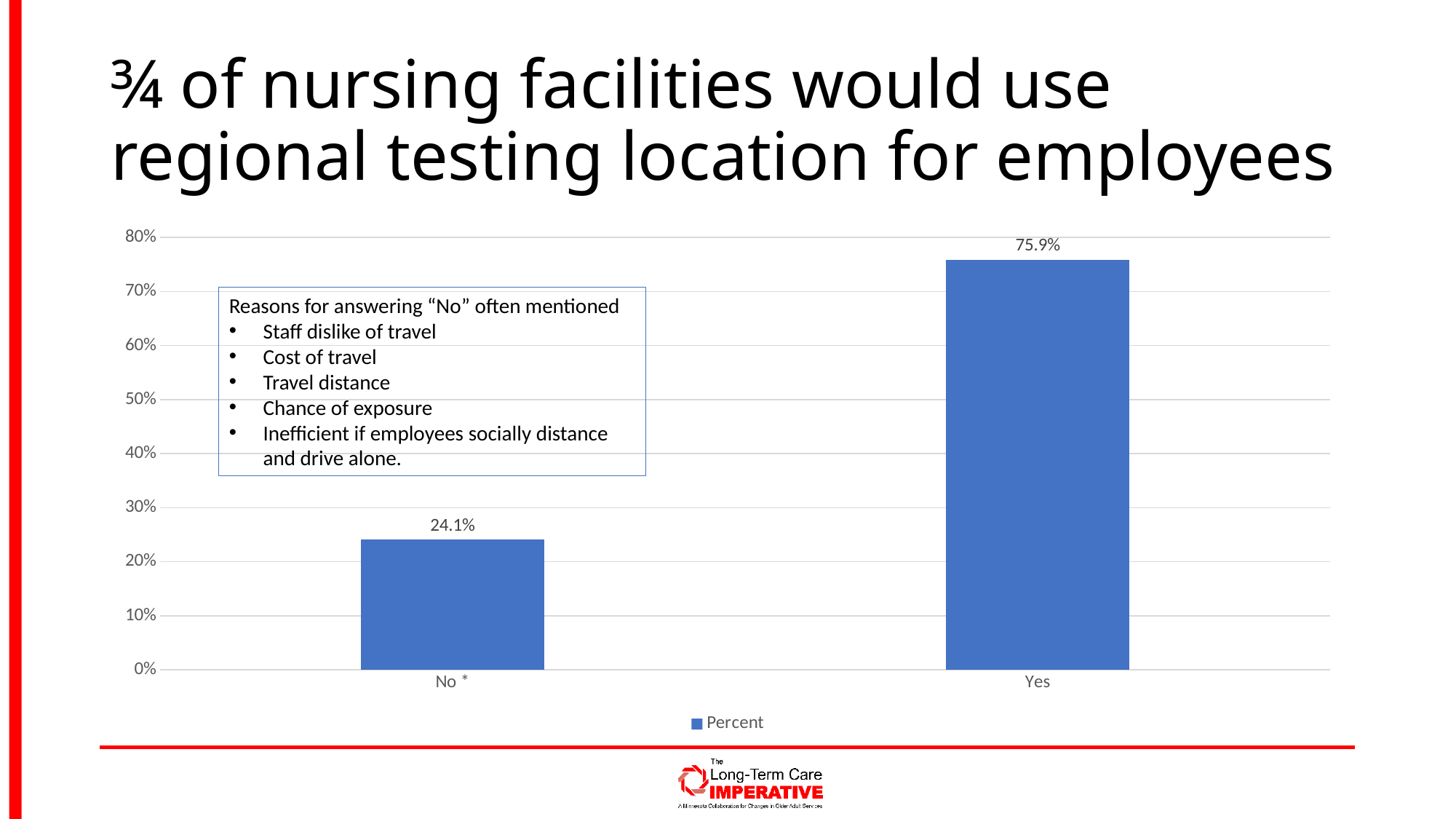
What kind of chart is shown on the slide? bar chart What is the difference between the values for Yes and No? 51.8% What is the value for No? 24.1% Which category has the lowest value? No Which is larger, the value for Yes or the value for No? Yes Is the value for No greater or less than 30%? less How many series does the legend list? 1 Which category has the highest value? Yes How many categories are shown on the x axis? 2 What is the value for Yes? 75.9% What is the name of the series shown in the legend? Percent Is the value for Yes greater or less than 70%? greater